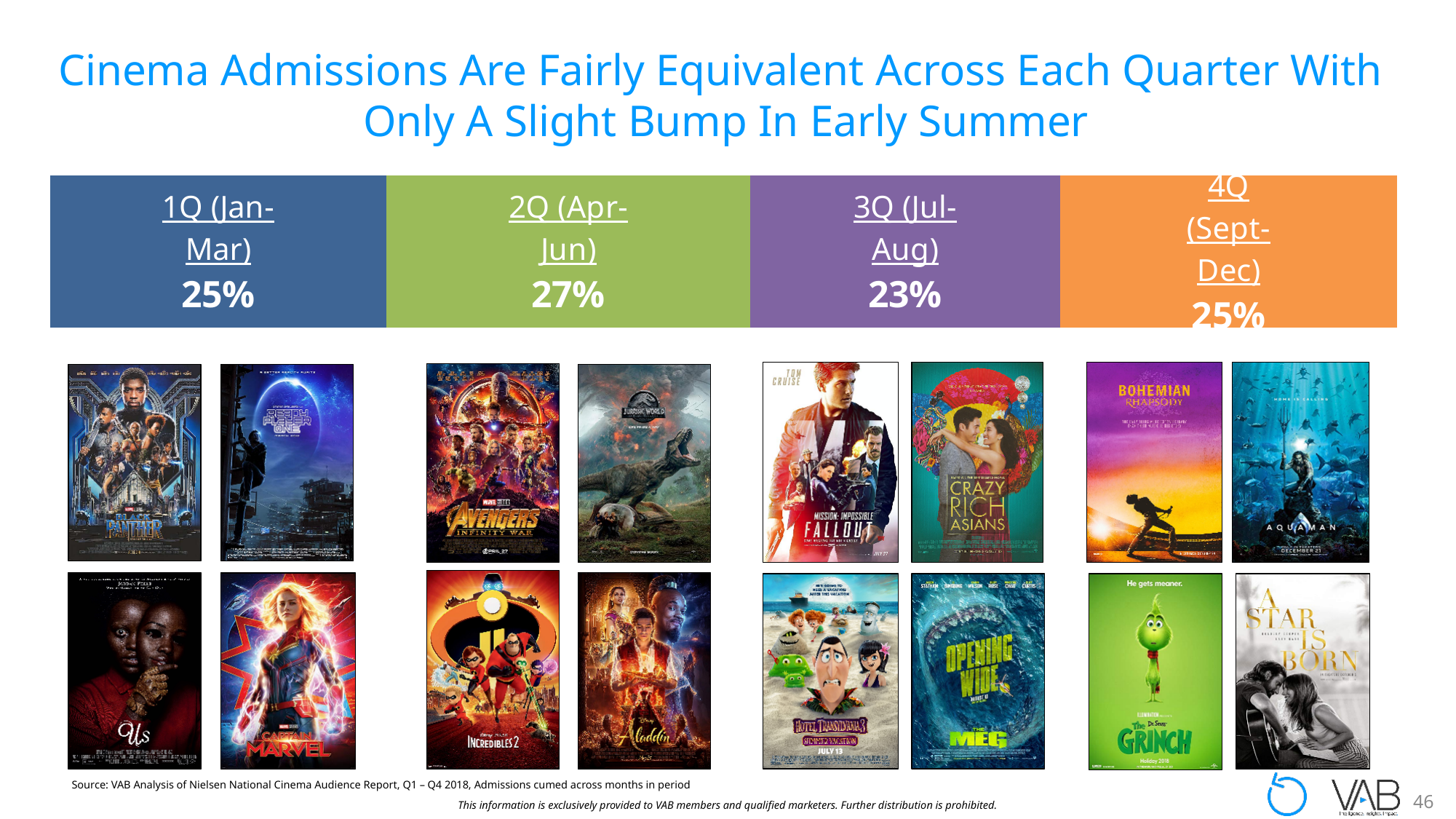
What share of cinema admissions occurred in 2Q (Apr-Jun)? 27% Which quarter has the lowest share of cinema admissions? 3Q (Jul-Aug) What is the title of the slide? Cinema Admissions Are Fairly Equivalent Across Each Quarter With Only A Slight Bump In Early Summer Which quarter has the highest share of cinema admissions? 2Q (Apr-Jun) What do the four quarterly admission shares add up to? 100% How many quarters are shown in the admissions breakdown? 4 What is the difference in percentage points between the 2Q and 3Q admission shares? 4 percentage points What share of cinema admissions occurred in 3Q (Jul-Aug)? 23% Which has a larger share of admissions, 1Q (Jan-Mar) or 2Q (Apr-Jun)? 2Q (Apr-Jun) What share of cinema admissions occurred in 4Q (Sept-Dec)? 25% What share of cinema admissions occurred in 1Q (Jan-Mar)? 25% What colour is the box for 2Q (Apr-Jun)? Green